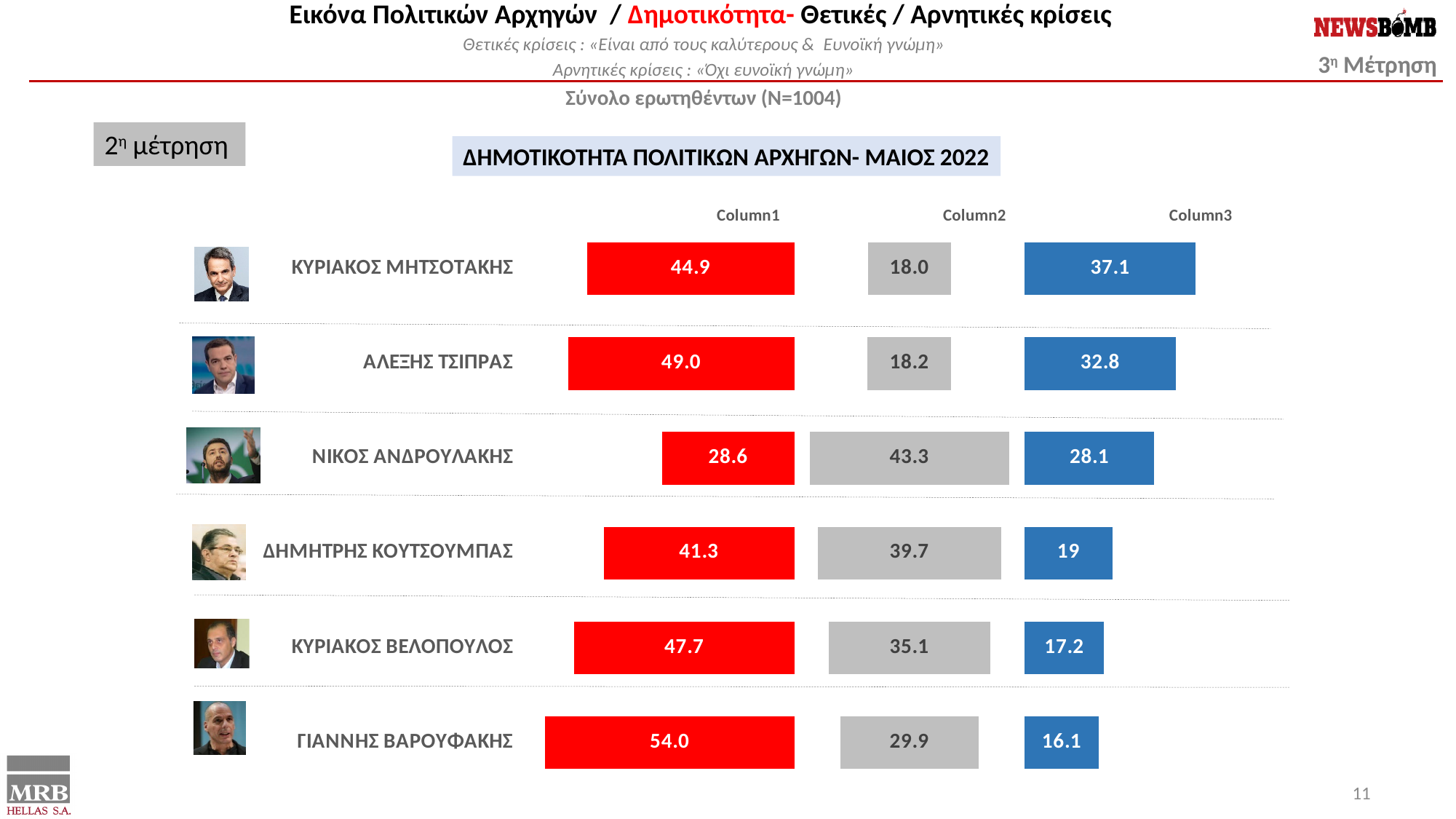
How many politicians are shown in the chart? 6 What is the Column1 value for ΚΥΡΙΑΚΟΣ ΜΗΤΣΟΤΑΚΗΣ? 44.9 Which politician has the lowest Column2 value? ΚΥΡΙΑΚΟΣ ΜΗΤΣΟΤΑΚΗΣ What is the difference between the Column1 and Column3 values for ΚΥΡΙΑΚΟΣ ΜΗΤΣΟΤΑΚΗΣ? 7.8 What is the Column2 value for ΝΙΚΟΣ ΑΝΔΡΟΥΛΑΚΗΣ? 43.3 How many series does the chart show? 3 What is the title of the chart? ΔΗΜΟΤΙΚΟΤΗΤΑ ΠΟΛΙΤΙΚΩΝ ΑΡΧΗΓΩΝ- ΜΑΙΟΣ 2022 Which politician has the highest Column1 value? ΓΙΑΝΝΗΣ ΒΑΡΟΥΦΑΚΗΣ Which politician has the lowest Column3 value? ΓΙΑΝΝΗΣ ΒΑΡΟΥΦΑΚΗΣ What is the Column3 value for ΚΥΡΙΑΚΟΣ ΒΕΛΟΠΟΥΛΟΣ? 17.2 Which is larger for ΑΛΕΞΗΣ ΤΣΙΠΡΑΣ: the Column1 value or the Column3 value? Column1 What kind of chart is shown on the slide? Bar chart